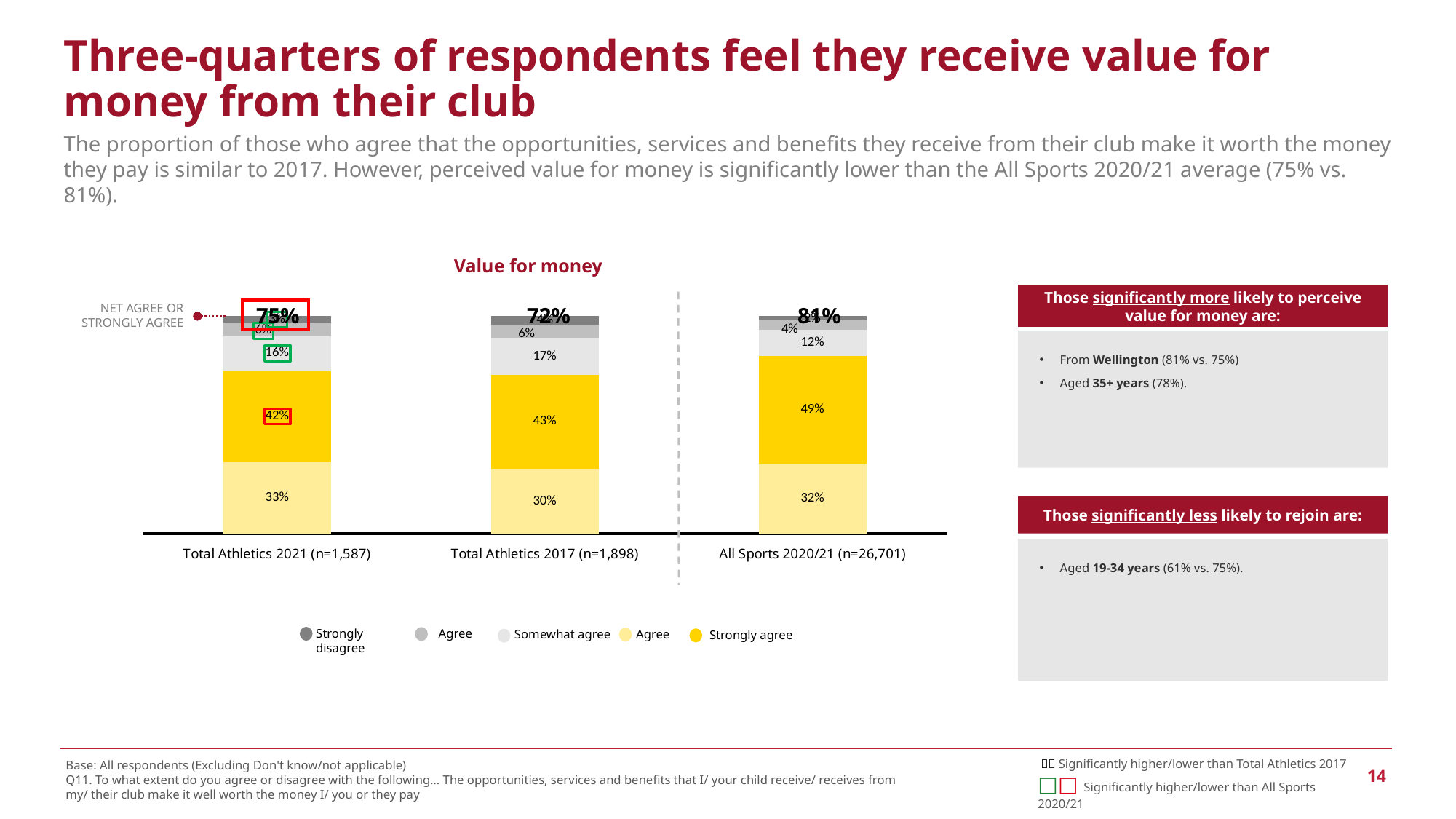
Which group has the lowest net agree or strongly agree percentage? Total Athletics 2017 (n=1,898) What percentage of All Sports 2020/21 respondents strongly agree? 49% Which has a higher strongly agree percentage, Total Athletics 2021 or Total Athletics 2017? Total Athletics 2017 What is the net agree or strongly agree percentage for Total Athletics 2021 (n=1,587)? 75% What percentage of All Sports 2020/21 respondents somewhat agree? 12% What is the net agree or strongly agree percentage for All Sports 2020/21 (n=26,701)? 81% What percentage of Total Athletics 2017 respondents somewhat agree? 17% Which group has the highest net agree or strongly agree percentage? All Sports 2020/21 (n=26,701) How many bars are shown in the Value for money chart? 3 How many entries does the legend of the chart list? 5 What type of chart is used to show Value for money? Stacked bar chart How many percentage points higher is the net agree figure for All Sports 2020/21 than for Total Athletics 2021? 6 percentage points